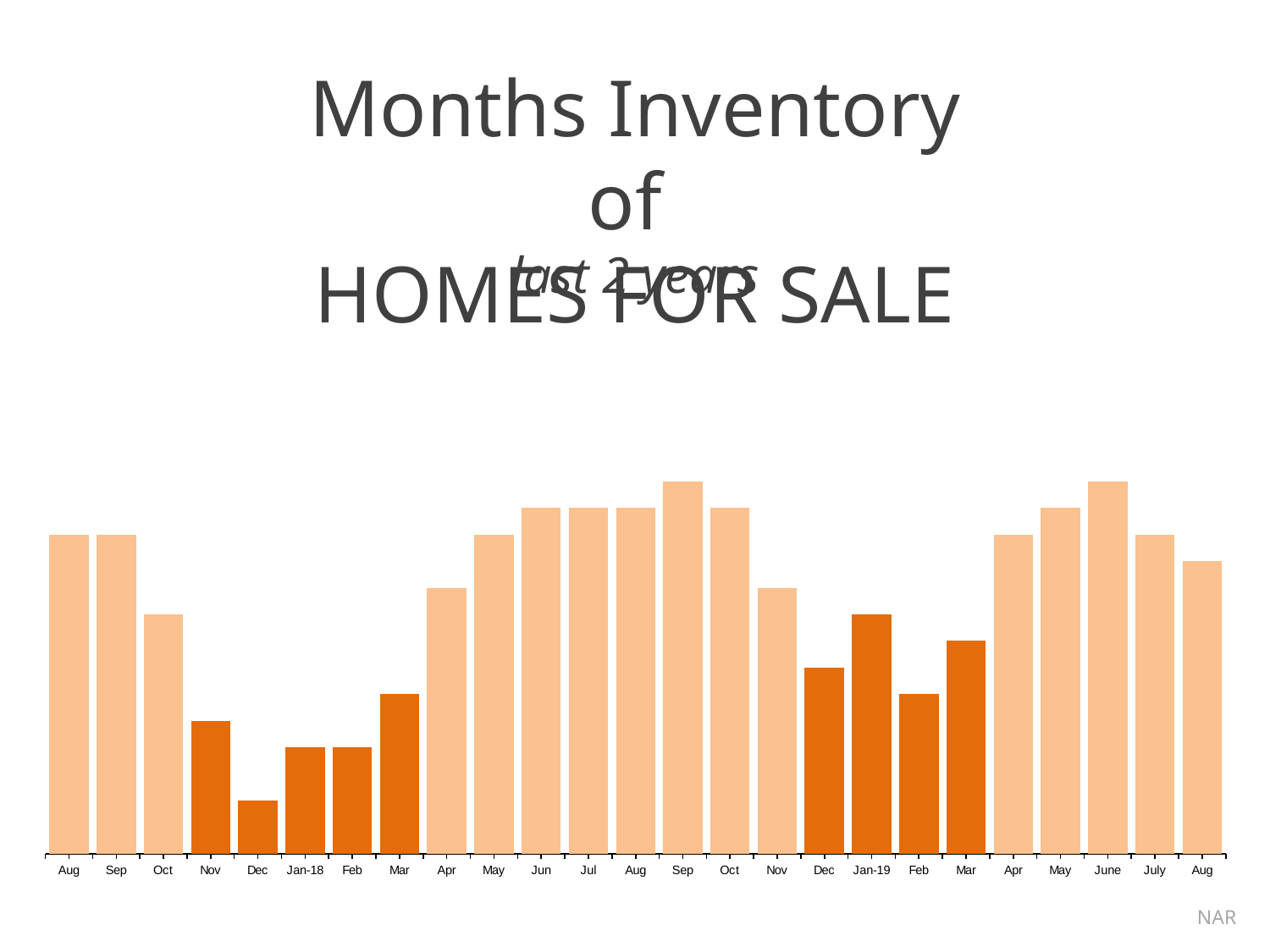
Which month has the lowest bar in the chart? Dec (the first Dec, before Jan-18) Which bar is taller, the Mar before Apr 2018 or the Mar after Feb 2019? the Mar after Feb 2019 What source is cited at the bottom right of the slide? NAR Do the bars rise or fall from Apr 2018 through Sep 2018? rise Which bar is taller, the first Aug (leftmost) or the last Aug (rightmost)? the first Aug (leftmost) Which bar is taller, Jan-18 or Jan-19? Jan-19 How many bars are drawn in the darker orange colour? 9 What is the title of the chart? Months Inventory of HOMES FOR SALE Do the bars rise or fall from June 2019 through Aug 2019? fall How many bars (months) are plotted in the chart? 25 What kind of chart is shown on the slide? bar chart